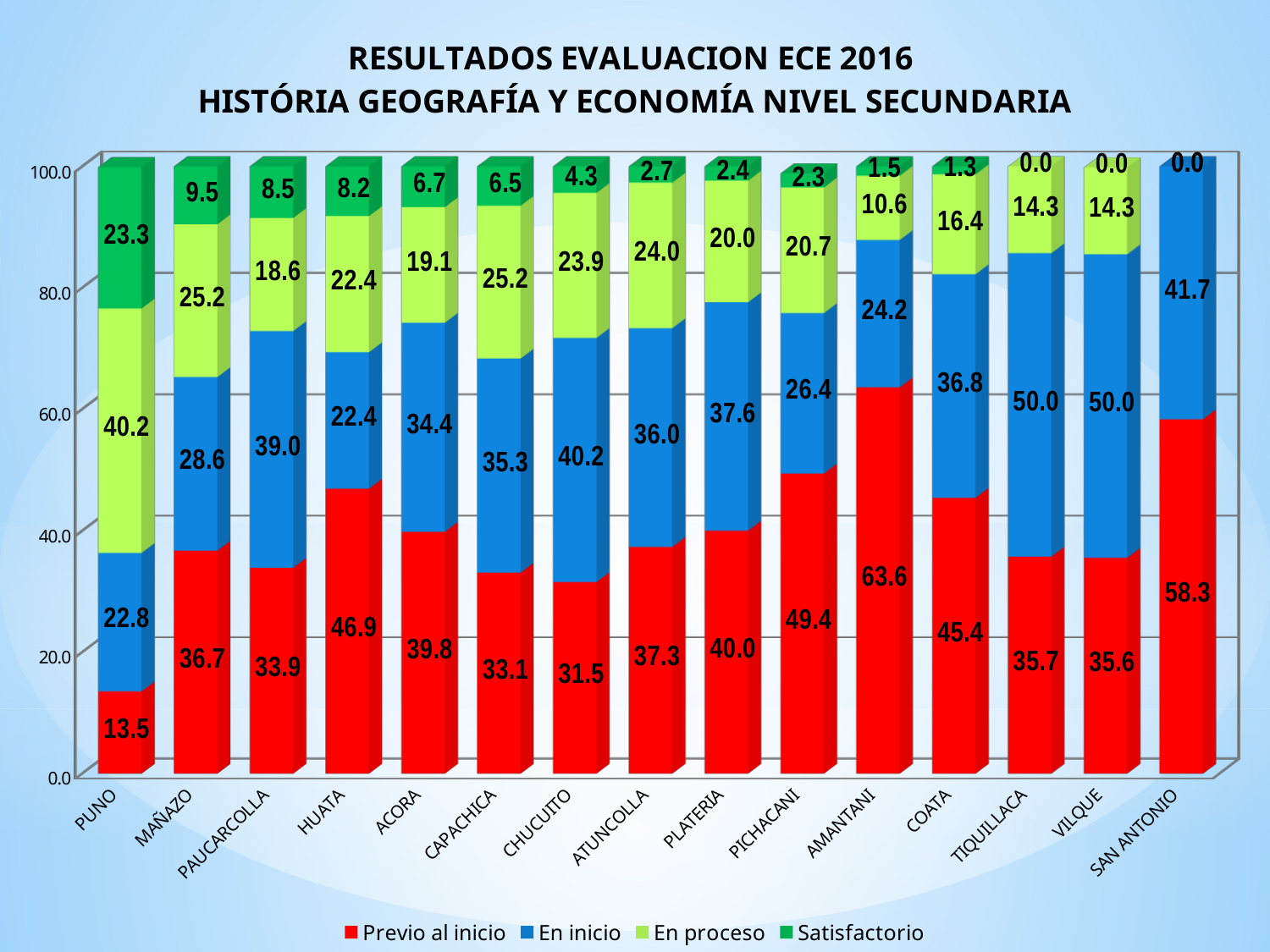
Which category has the highest Previo al inicio value? AMANTANI Which category has the lowest Previo al inicio value? PUNO What is the difference between the Previo al inicio values for SAN ANTONIO and PICHACANI? 8.9 What is the Satisfactorio value for PUNO? 23.3 What is the En inicio value for TIQUILLACA? 50.0 Which is larger, the En inicio value for CHUCUITO or the En inicio value for MAÑAZO? CHUCUITO How many series does the legend list? 4 What kind of chart is shown on the slide? Stacked bar chart How many categories are shown on the x axis? 15 What is the En proceso value for COATA? 16.4 What is the Previo al inicio value for AMANTANI? 63.6 Do the Satisfactorio values rise or fall from left to right along the x axis? Fall